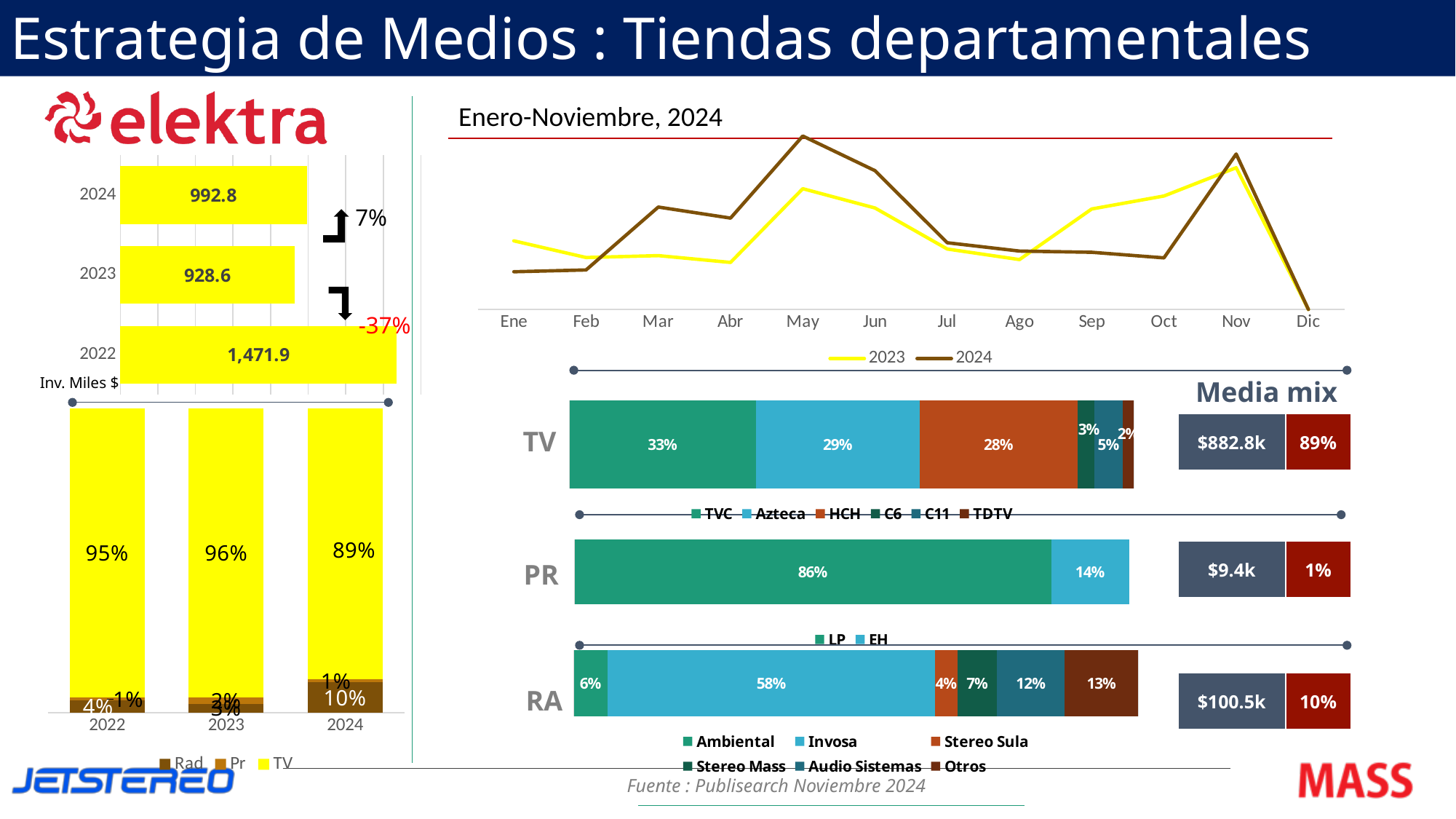
In the line chart titled Enero-Noviembre, 2024, which series is higher in Mar, 2023 or 2024? 2024 In the horizontal bar chart on the left (Inv. Miles $), what is the value for 2022? 1,471.9 In the TV stacked bar on the right, which channel has the smallest share? TDTV In the horizontal bar chart on the left (Inv. Miles $), which year has the highest value? 2022 In the horizontal bar chart on the left (Inv. Miles $), what is the difference between the 2024 and 2023 values? 64.2 In the RA stacked bar on the right, what is the difference between the Invosa and Ambiental shares? 52% What kind of chart is the Enero-Noviembre, 2024 chart? Line chart In the TV stacked bar on the right, what is the share for TVC? 33% In the line chart titled Enero-Noviembre, 2024, how many series does the legend list? 2 In the Media mix boxes on the right, what is the amount shown for TV? $882.8k In the stacked bar chart at the bottom left, what is the TV share for 2024? 89% In the line chart titled Enero-Noviembre, 2024, in which month does the 2024 series reach its highest point? May